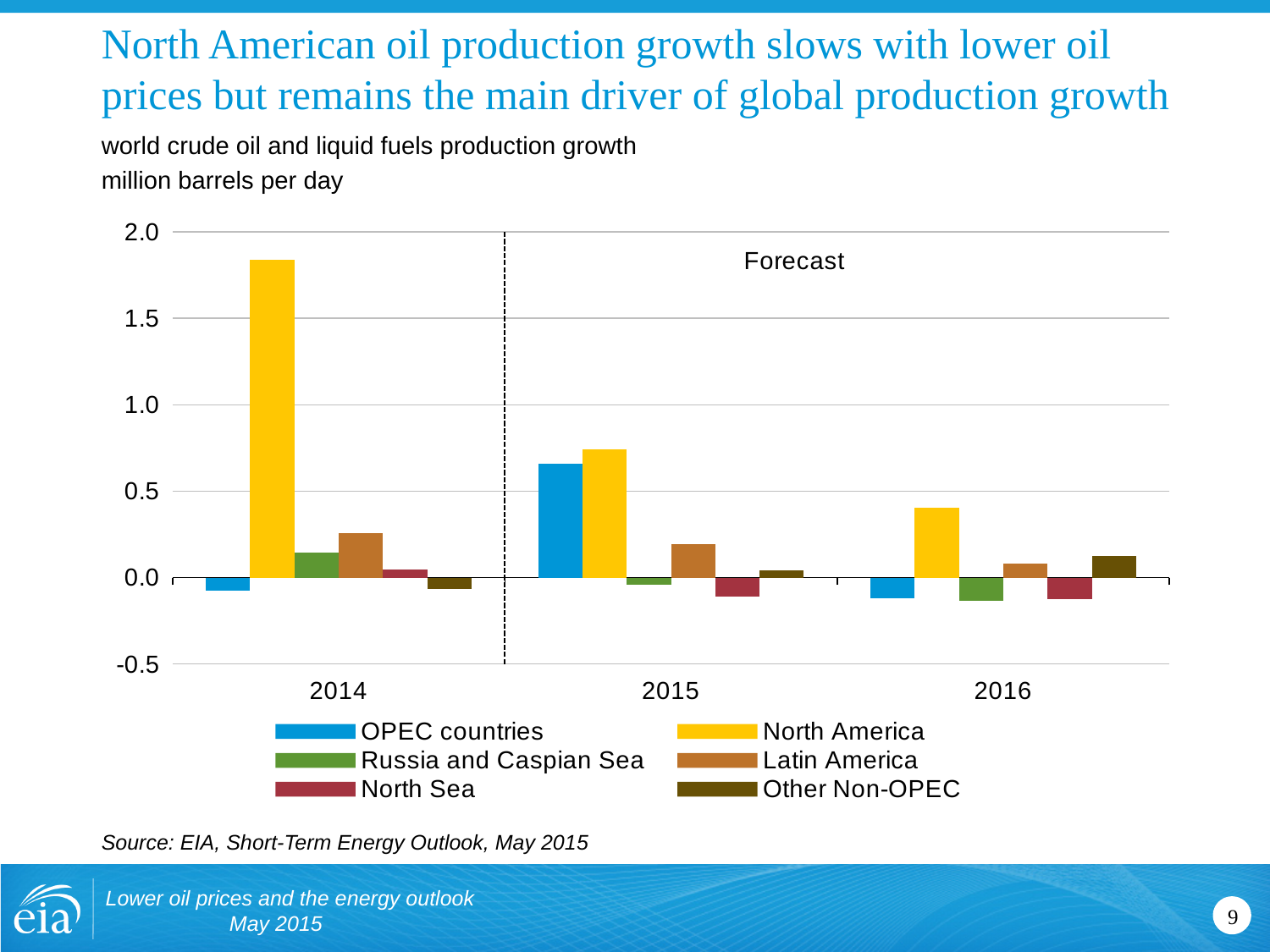
How many years are shown on the x axis? 3 Which is larger: North America's production growth in 2014 or in 2015? 2014 What unit is the chart measured in? million barrels per day Is the value for OPEC countries in 2015 greater or less than 0.5? greater What label appears to the right of the dashed vertical line? Forecast Is the value for North America in 2016 greater or less than 0.5? less Which region has the lowest production growth in 2015? North Sea What kind of chart is shown on the slide? bar chart Does North America's production growth rise or fall from 2014 to 2016? fall How many series does the legend list? 6 Which region has the highest production growth in 2014? North America Is the value for North America in 2014 greater or less than 1.5? greater